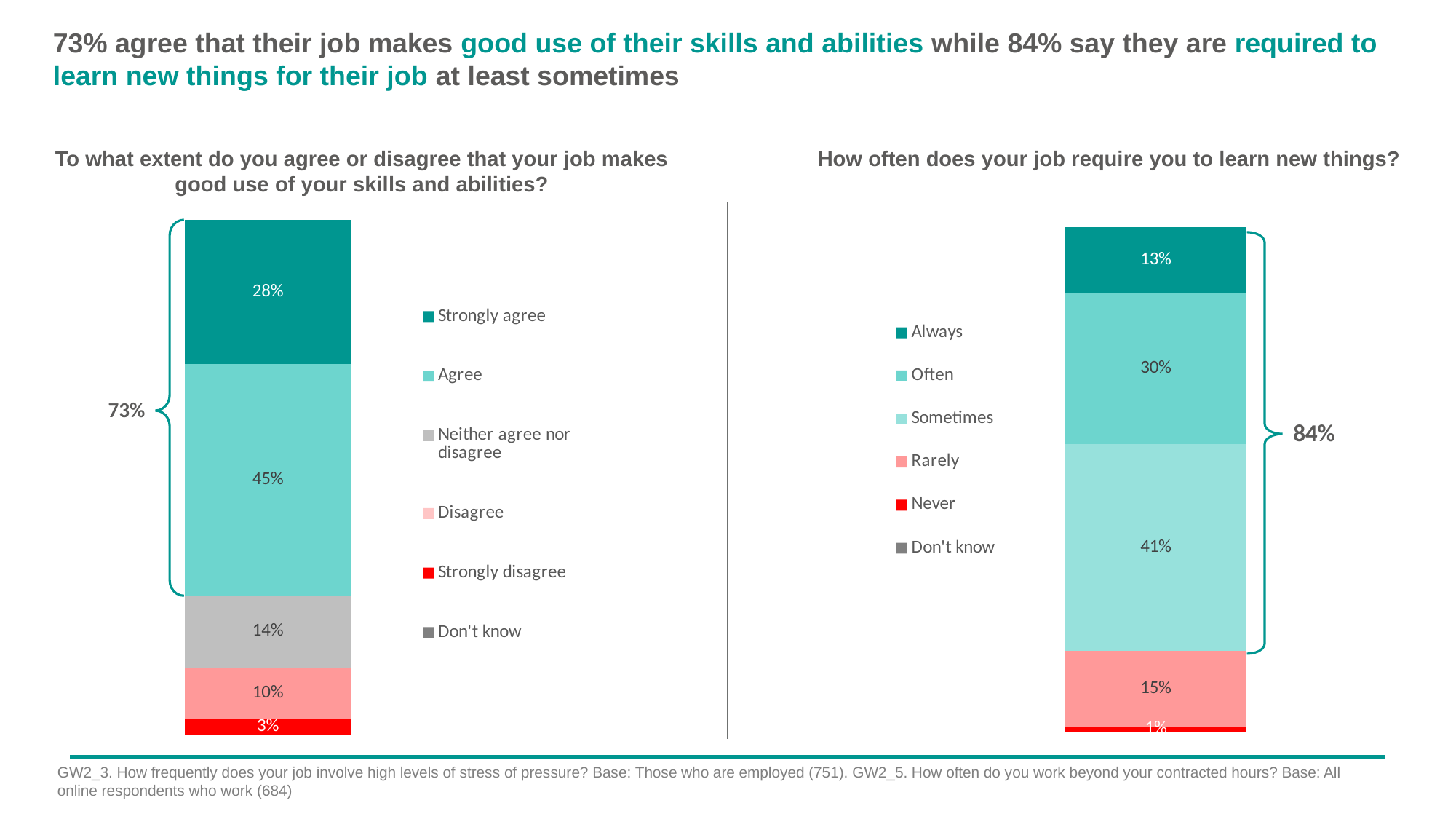
In the right chart on how often the job requires learning new things, which response has the smallest share? Never In the left chart on job making good use of skills and abilities, what percentage said 'Strongly disagree'? 3% How many entries does the legend of the right chart on how often the job requires learning new things list? 6 In the right chart on how often the job requires learning new things, what percentage said 'Sometimes'? 41% In the right chart on how often the job requires learning new things, which is larger: 'Often' or 'Rarely'? Often In the right chart on how often the job requires learning new things, what is the combined percentage for 'Always', 'Often' and 'Sometimes' shown by the bracket? 84% In the left chart on job making good use of skills and abilities, what is the difference between the 'Strongly agree' and 'Neither agree nor disagree' percentages? 14% In the left chart on job making good use of skills and abilities, what combined percentage does the bracket show for 'Strongly agree' and 'Agree'? 73% What type of chart is used on the left for the question about job making good use of skills and abilities? Stacked bar chart In the right chart on how often the job requires learning new things, what percentage said 'Always'? 13% In the left chart on job making good use of skills and abilities, which response has the largest share? Agree In the left chart on job making good use of skills and abilities, what percentage of respondents said 'Agree'? 45%